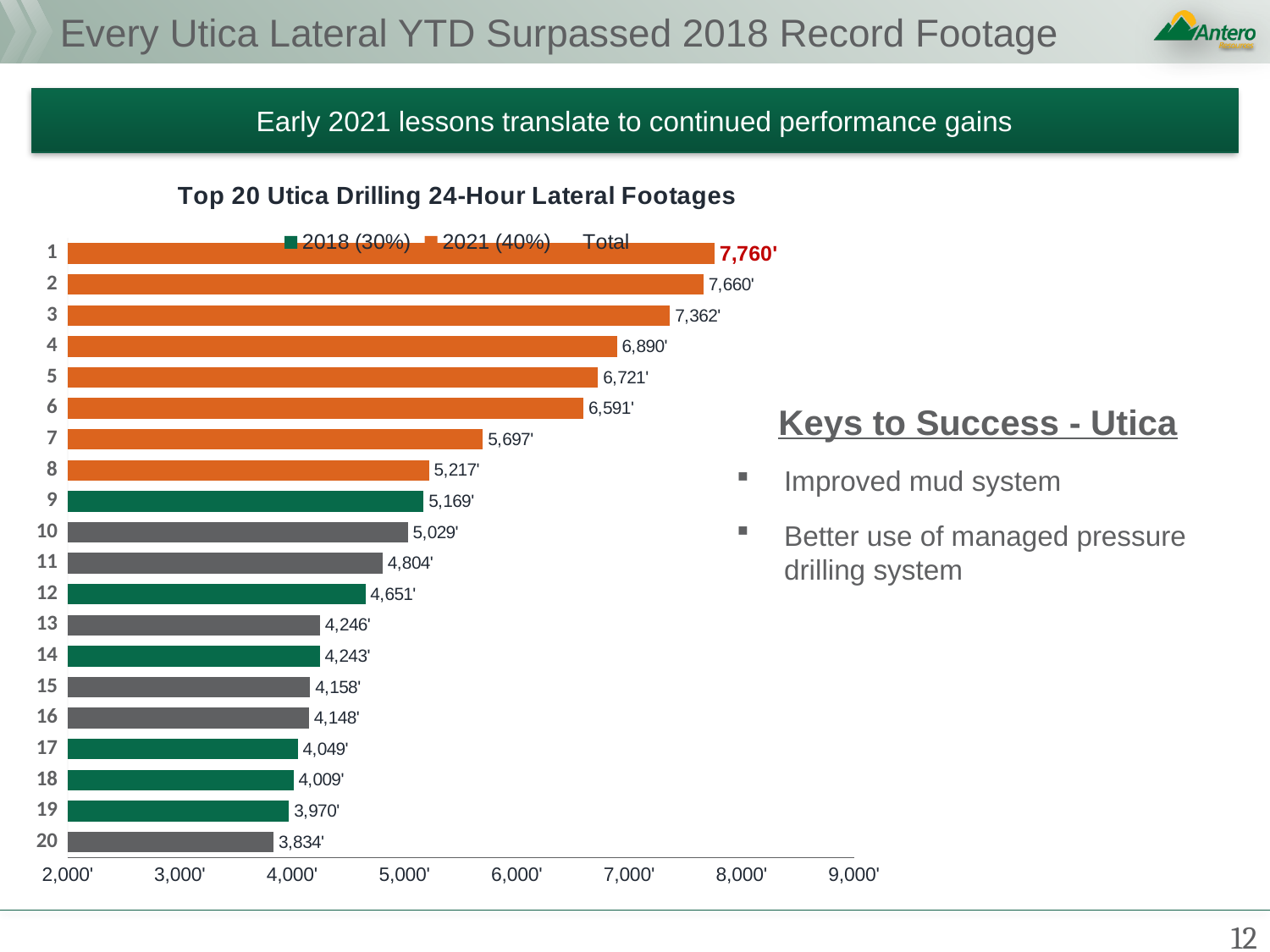
What kind of chart is used to show the Top 20 Utica Drilling 24-Hour Lateral Footages? Bar chart How many ranked bars are shown in the chart? 20 What is the difference between the lateral footage for rank 8 and rank 9? 48' Which rank has the lowest lateral footage? 20 What is the lateral footage value for rank 10? 5,029' Which rank has the highest lateral footage? 1 What is the lateral footage value for rank 20? 3,834' What is the lateral footage value for rank 1 in the Top 20 Utica Drilling 24-Hour Lateral Footages chart? 7,760' How many series does the chart legend list? 3 Is the value for rank 7 greater or less than 6,000'? less What is the difference between the lateral footage for rank 1 and rank 2? 100' Which has a larger lateral footage, rank 3 or rank 6? Rank 3